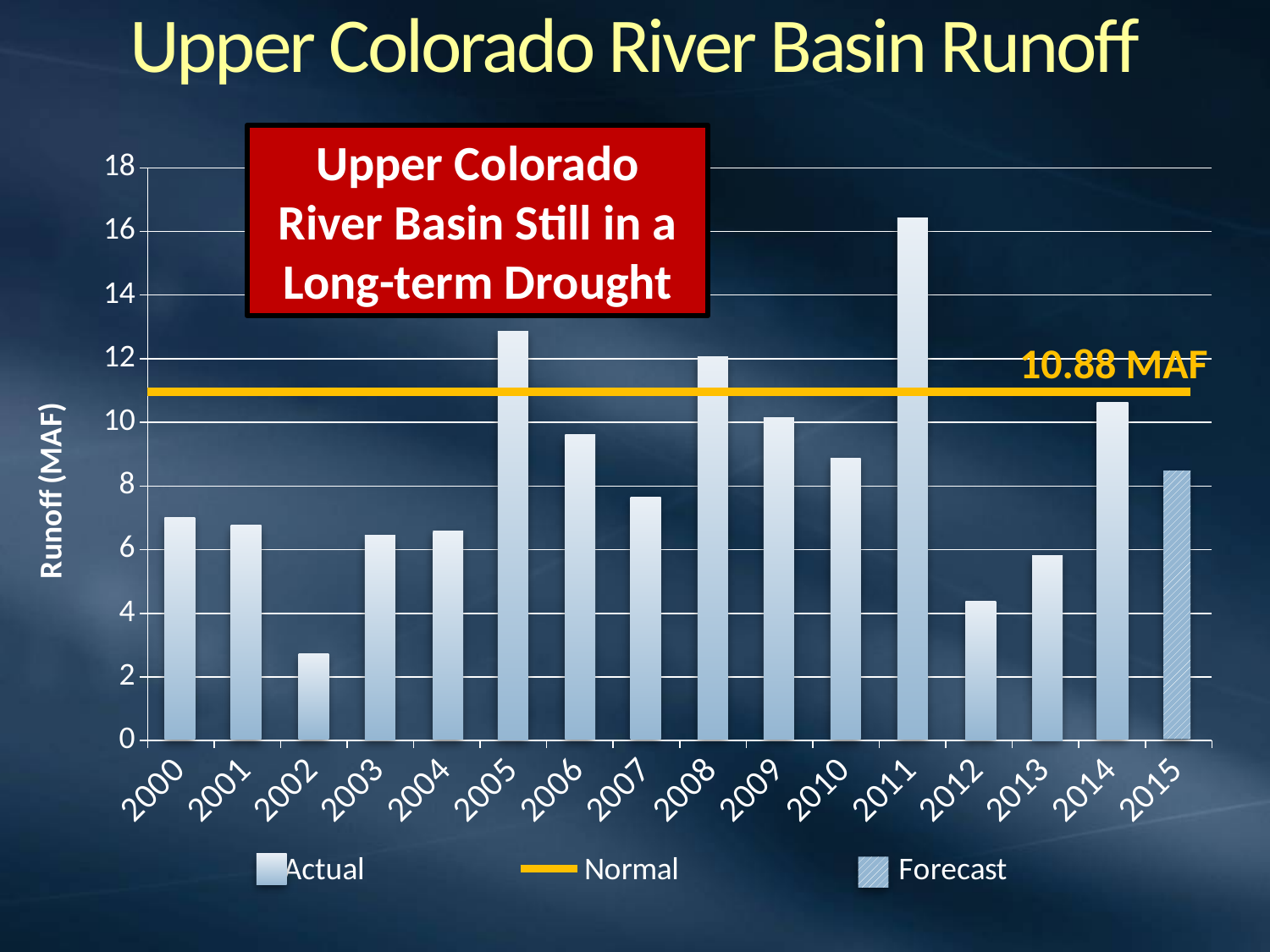
Which year has higher runoff, 2008 or 2012? 2008 How many years are shown on the x axis? 16 Is the runoff for 2011 greater or less than 16? greater Which year has the highest runoff? 2011 Which legend entry is shown with a hatched pattern? Forecast What is the value of the Normal line labelled on the chart? 10.88 MAF What is the label on the y axis? Runoff (MAF) What kind of chart is shown on the slide? bar chart Which year has the lowest runoff? 2002 Is the runoff for 2005 greater or less than 12? greater How many entries does the legend list? 3 Is the runoff for 2002 greater or less than 4? less